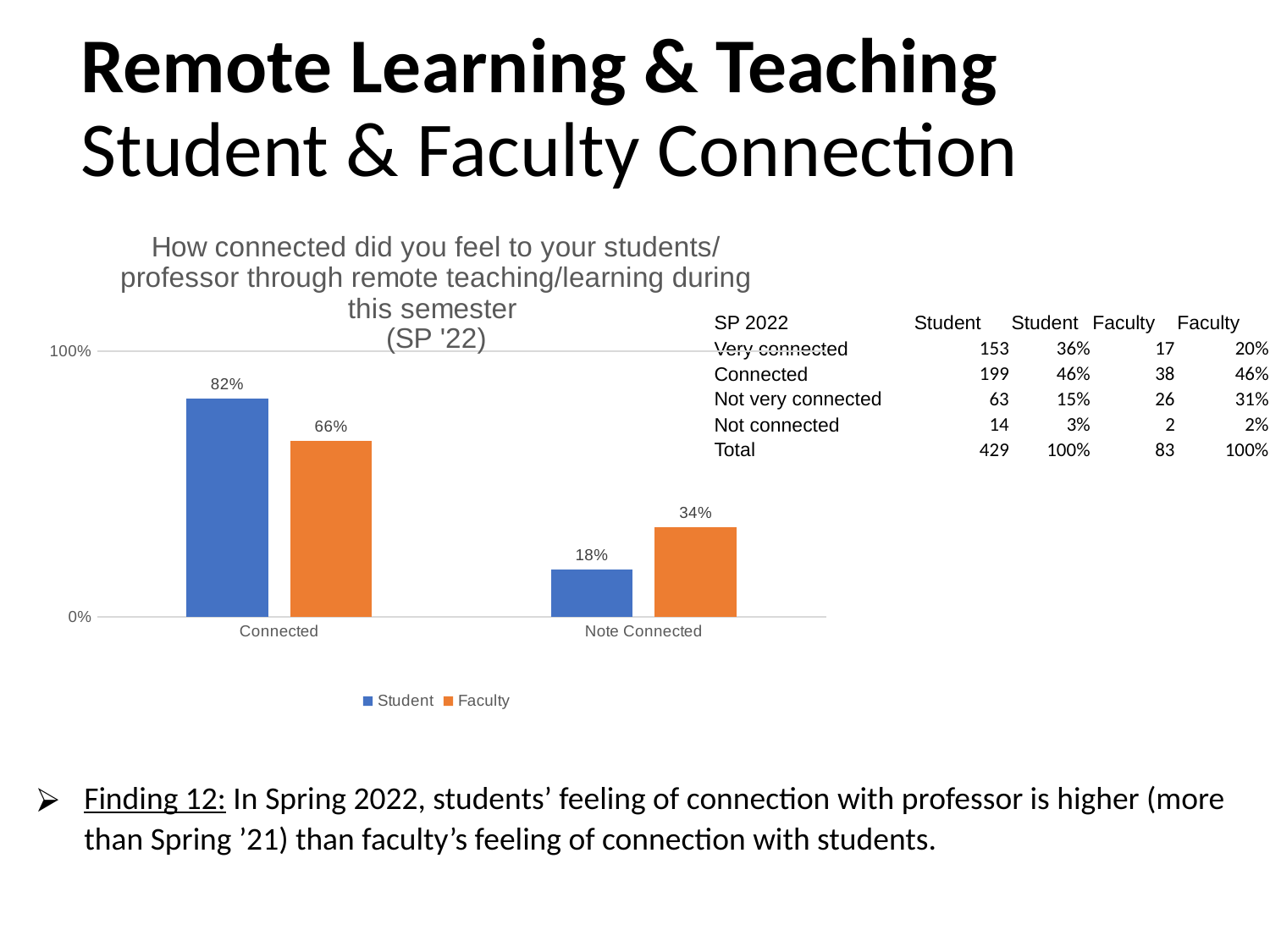
What is the Faculty value for the Note Connected category? 34% What is the difference between the Faculty and Student values for the Note Connected category? 16% What is the Student value for the Note Connected category? 18% Which bar in the chart has the lowest value? Student, Note Connected (18%) What is the Faculty value for the Connected category? 66% Which series has the higher value in the Connected category, Student or Faculty? Student What is the Student value for the Connected category? 82% Which bar in the chart has the highest value? Student, Connected (82%) Which series has the higher value in the Note Connected category, Student or Faculty? Faculty What type of chart is shown on the slide? Bar chart How many series does the legend list? 2 What is the difference between the Student and Faculty values for the Connected category? 16%